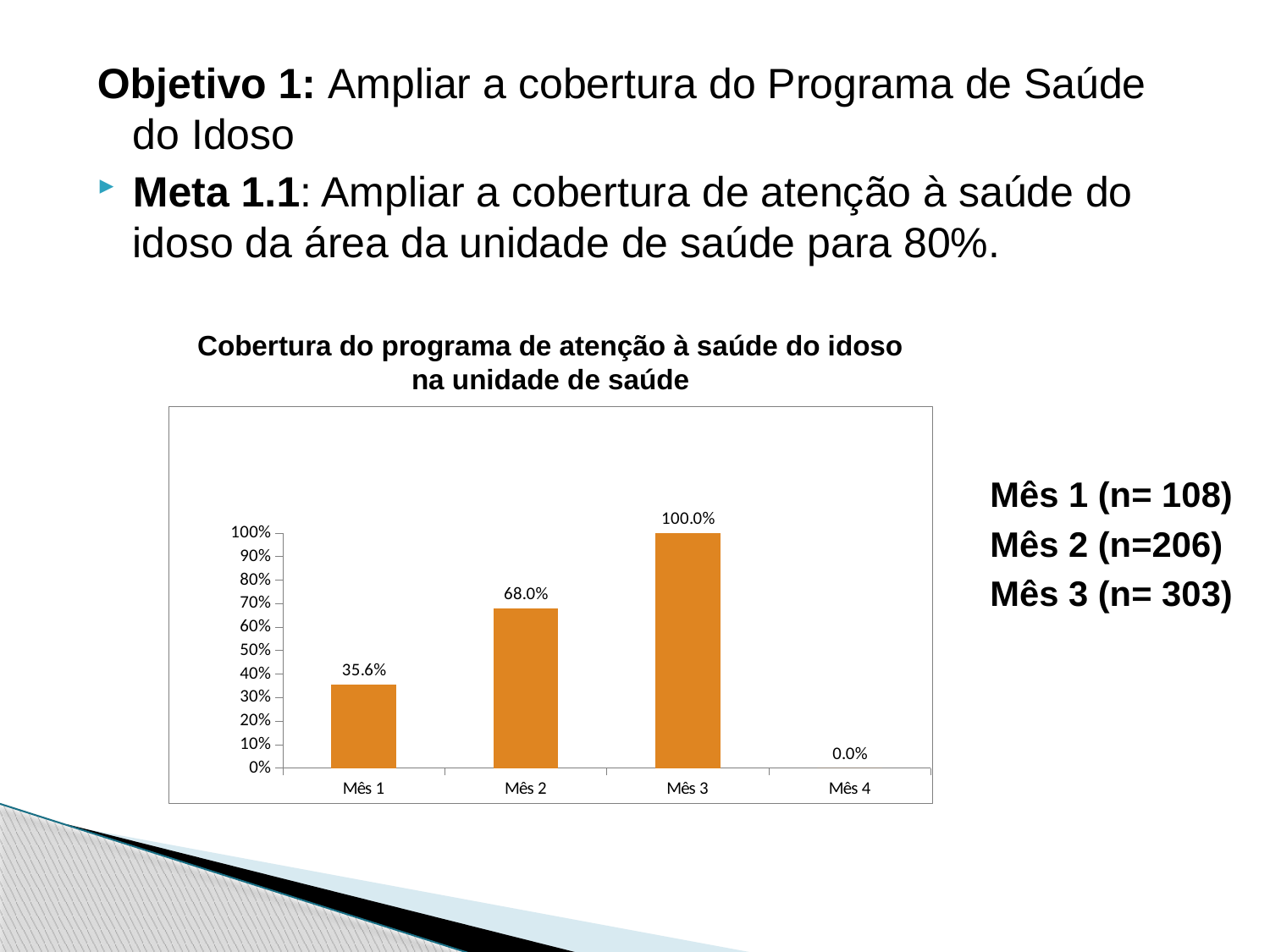
Which month has the highest value? Mês 3 Which month has the lowest value? Mês 4 What is the value for Mês 3? 100.0% What is the difference between the values for Mês 3 and Mês 2? 32.0% What is the value for Mês 1? 35.6% What is the value for Mês 4? 0.0% Which is larger, the value for Mês 1 or the value for Mês 2? Mês 2 What kind of chart is this? Bar chart How many categories are shown on the x axis? 4 What is the difference between the values for Mês 2 and Mês 1? 32.4% What is the value for Mês 2? 68.0% What is the title of the chart? Cobertura do programa de atenção à saúde do idoso na unidade de saúde